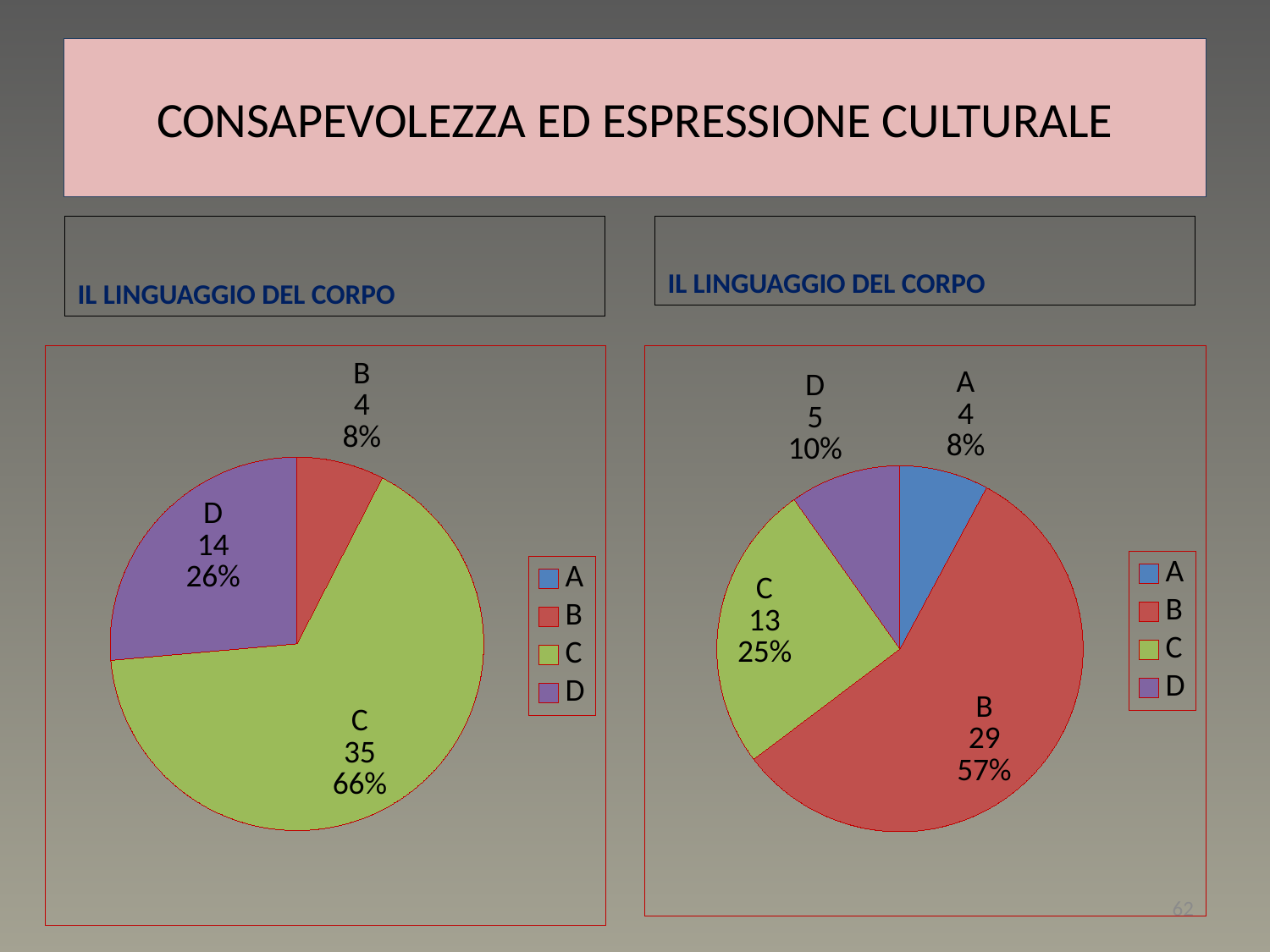
In the right pie chart, how many slices are there? 4 In the left pie chart, what is the value shown for category C? 35 In the left pie chart, which labeled category has the smallest slice? B In the left pie chart, what percentage share does category D have? 26% In the left pie chart, which category has the largest slice? C In the right pie chart, what is the value shown for category B? 29 In the right pie chart, which category has the largest slice? B In the left pie chart, what is the difference between the values for C and D? 21 In the right pie chart, which category has the smallest slice? A In the right pie chart, what percentage share does category C have? 25% What type of chart is shown on the left side of the slide? Pie chart In the right pie chart, what is the difference between the values for B and C? 16